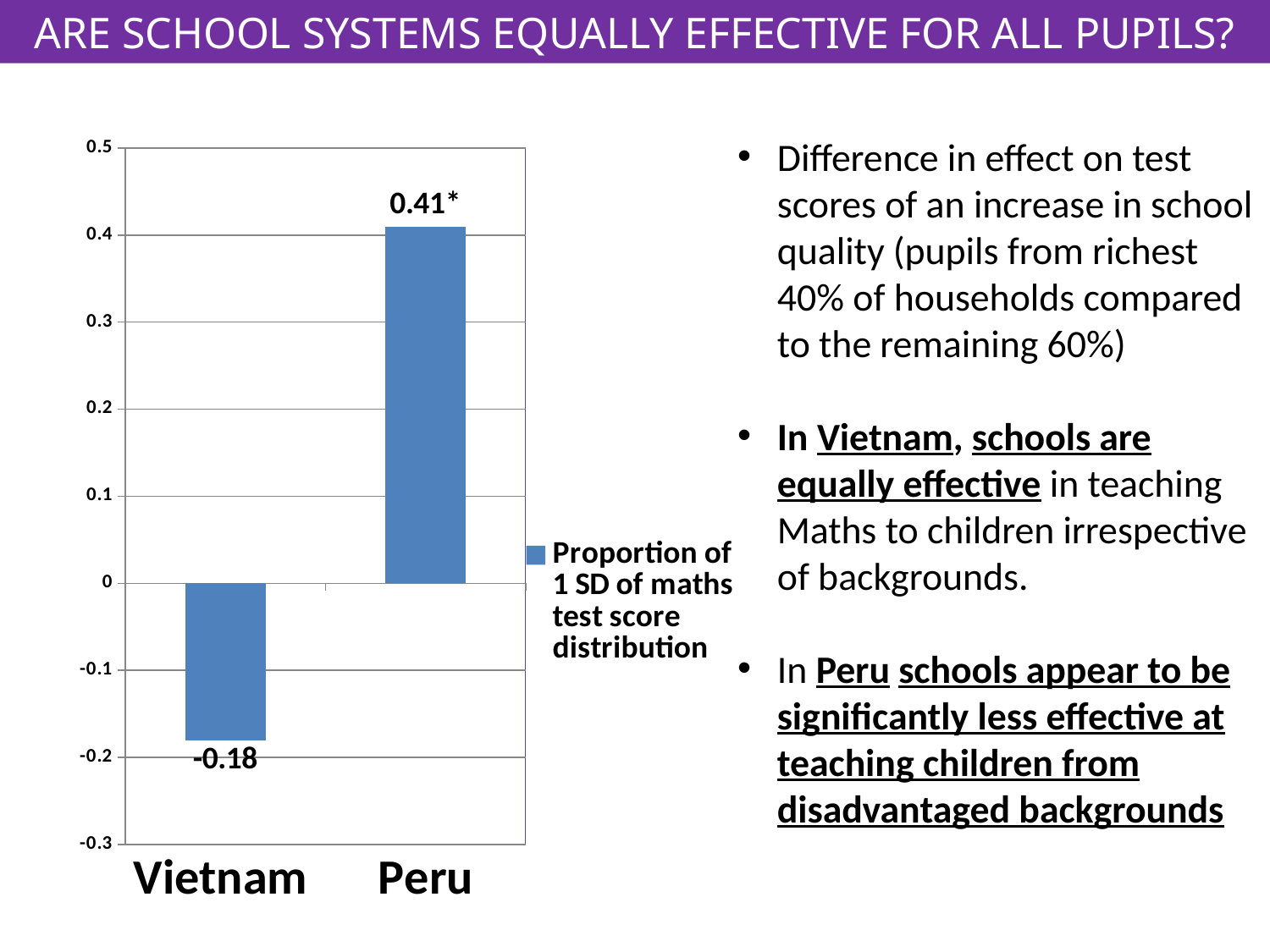
Which country has the higher value? Peru Is the value for Peru greater or less than 0.3? greater Is the value for Vietnam greater or less than 0? less What is the value for Vietnam? -0.18 How many countries are shown in the chart? 2 How many series does the legend list? 1 What is the legend entry of the chart? Proportion of 1 SD of maths test score distribution What is the difference between the values for Peru and Vietnam? 0.59 What kind of chart is shown on the slide? bar chart Which country has the lower value? Vietnam Is the value for Vietnam larger or smaller than the value for Peru? smaller What is the value for Peru? 0.41*